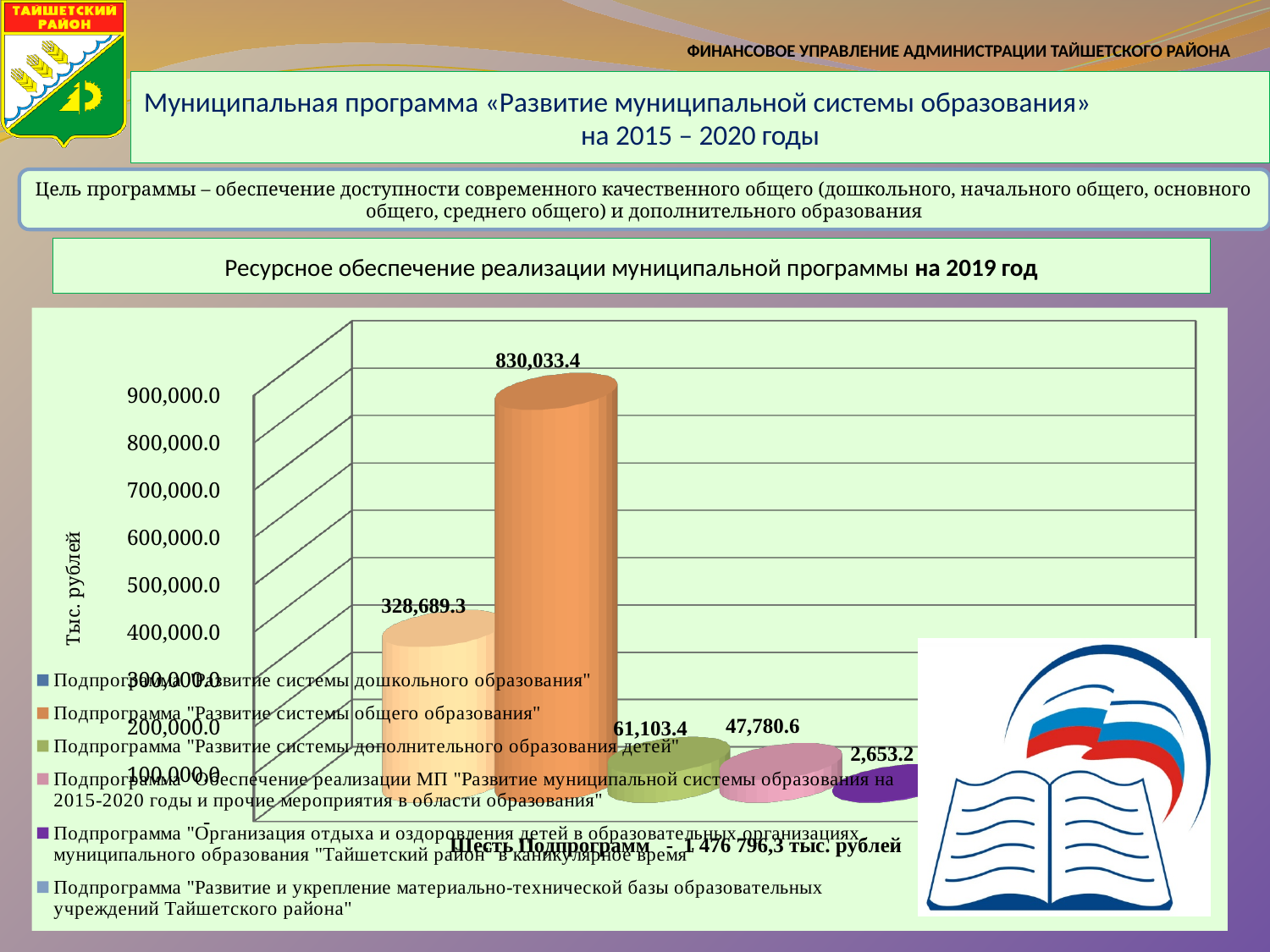
What is the difference between the values 830,033.4 and 328,689.3 shown on the chart? 501,344.1 What value is shown for the subprogram "Организация отдыха и оздоровления детей в образовательных организациях муниципального образования "Тайшетский район" в каникулярное время"? 2,653.2 Is the value for "Развитие системы общего образования" greater or less than 800,000.0? greater What value is shown for the subprogram "Развитие системы общего образования"? 830,033.4 Which subprogram has the highest value in the chart? Подпрограмма "Развитие системы общего образования" How many subprograms does the chart legend list? 6 Which of the labelled bars has the lowest value? 2,653.2 (Подпрограмма "Организация отдыха и оздоровления детей...") What type of chart is shown on the slide? bar chart What is the label on the vertical axis of the chart? Тыс. рублей Which is larger: the value for "Развитие системы дополнительного образования детей" or the value for "Обеспечение реализации МП..."? Развитие системы дополнительного образования детей (61,103.4) What value is shown for the subprogram "Развитие системы дошкольного образования"? 328,689.3 What value is shown for the subprogram "Развитие системы дополнительного образования детей"? 61,103.4